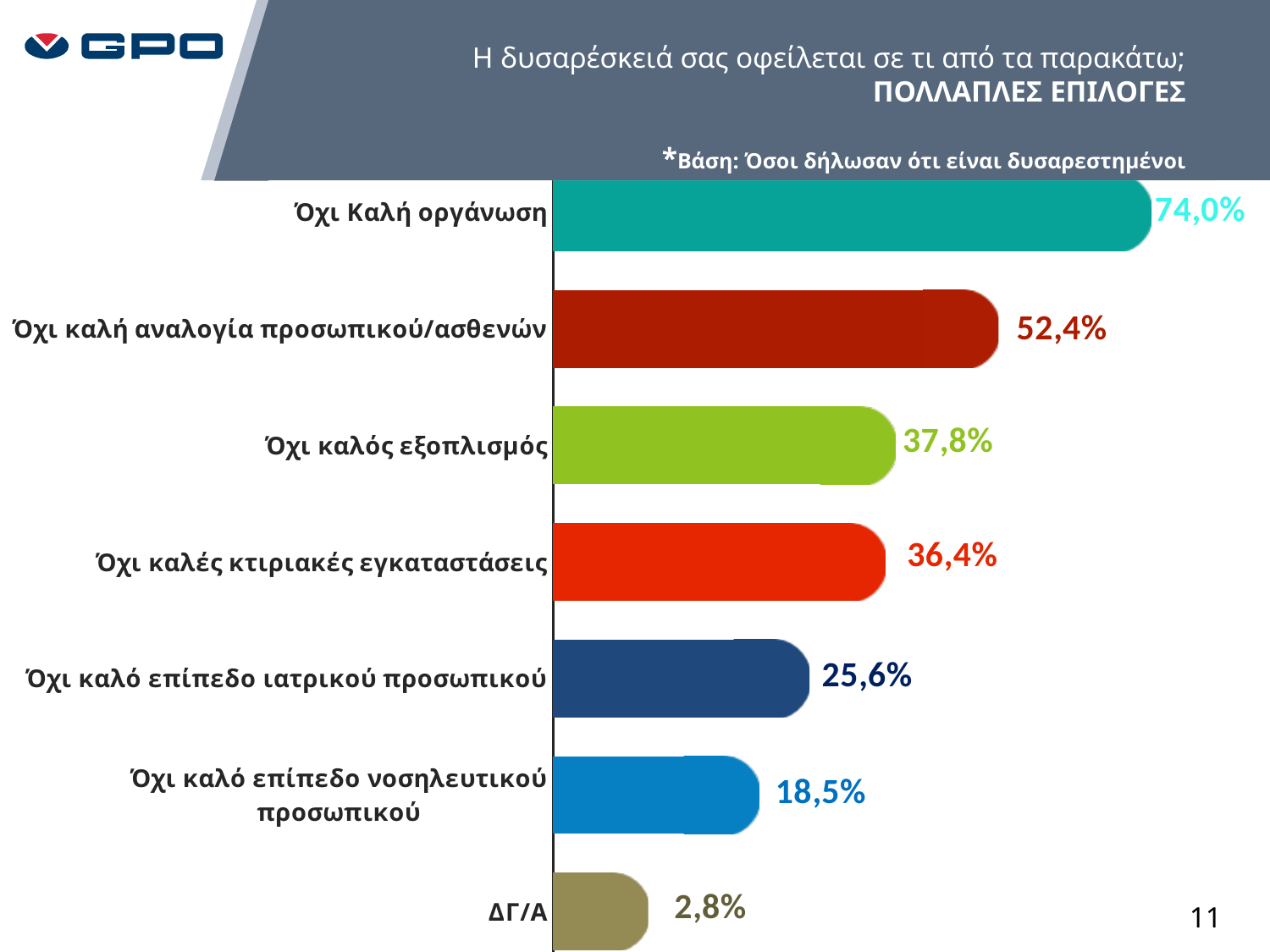
What kind of chart is shown on the slide? Bar chart What is the base (Βάση) noted above the chart? Όσοι δήλωσαν ότι είναι δυσαρεστημένοι What is the value for "ΔΓ/Α"? 2,8% What is the difference between the values for "Όχι καλός εξοπλισμός" and "Όχι καλές κτιριακές εγκαταστάσεις"? 1,4% How many categories are shown in the chart? 7 Which is larger, the value for "Όχι καλό επίπεδο ιατρικού προσωπικού" or the value for "Όχι καλό επίπεδο νοσηλευτικού προσωπικού"? Όχι καλό επίπεδο ιατρικού προσωπικού What is the value for "Όχι καλό επίπεδο νοσηλευτικού προσωπικού"? 18,5% Which category has the highest value? Όχι Καλή οργάνωση Which category has the lowest value? ΔΓ/Α What is the difference between the values for "Όχι Καλή οργάνωση" and "Όχι καλή αναλογία προσωπικού/ασθενών"? 21,6% What is the value for "Όχι Καλή οργάνωση"? 74,0% What is the value for "Όχι καλή αναλογία προσωπικού/ασθενών"? 52,4%